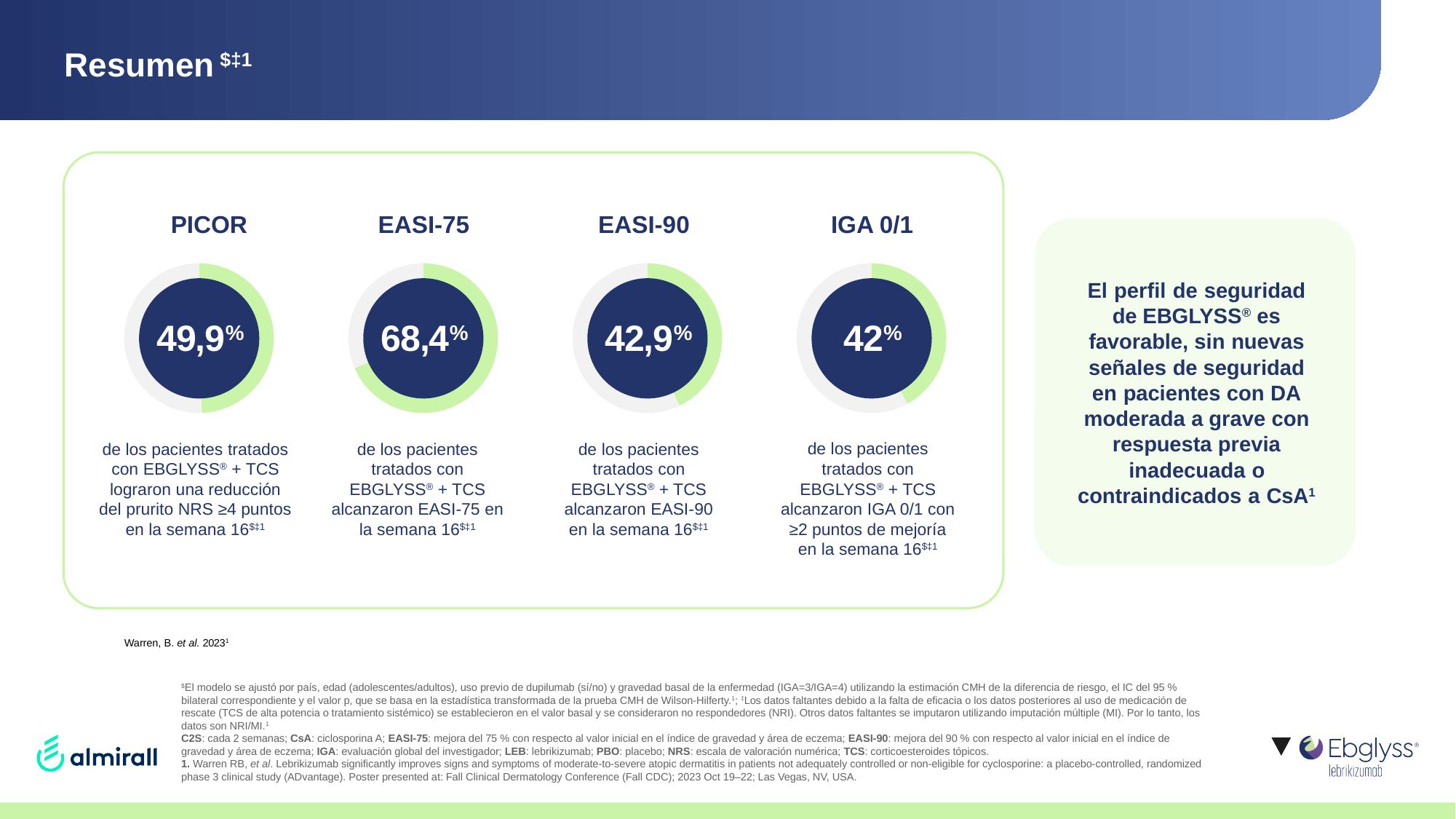
What is the difference between the EASI-75 percentage and the EASI-90 percentage? 25,5% What kind of chart is used to display the percentages on the slide? Donut chart What percentage is shown in the PICOR chart? 49,9% What percentage is shown in the EASI-90 chart? 42,9% What colour is the filled portion of the ring in each chart? Light green Which is larger, the PICOR percentage or the EASI-90 percentage? PICOR Which of the four charts shows the highest percentage? EASI-75 Which of the four charts shows the lowest percentage? IGA 0/1 What percentage is shown in the IGA 0/1 chart? 42% What percentage is shown in the EASI-75 chart? 68,4% How many circular charts are shown on the slide? 4 What is the difference between the EASI-75 percentage and the PICOR percentage? 18,5%